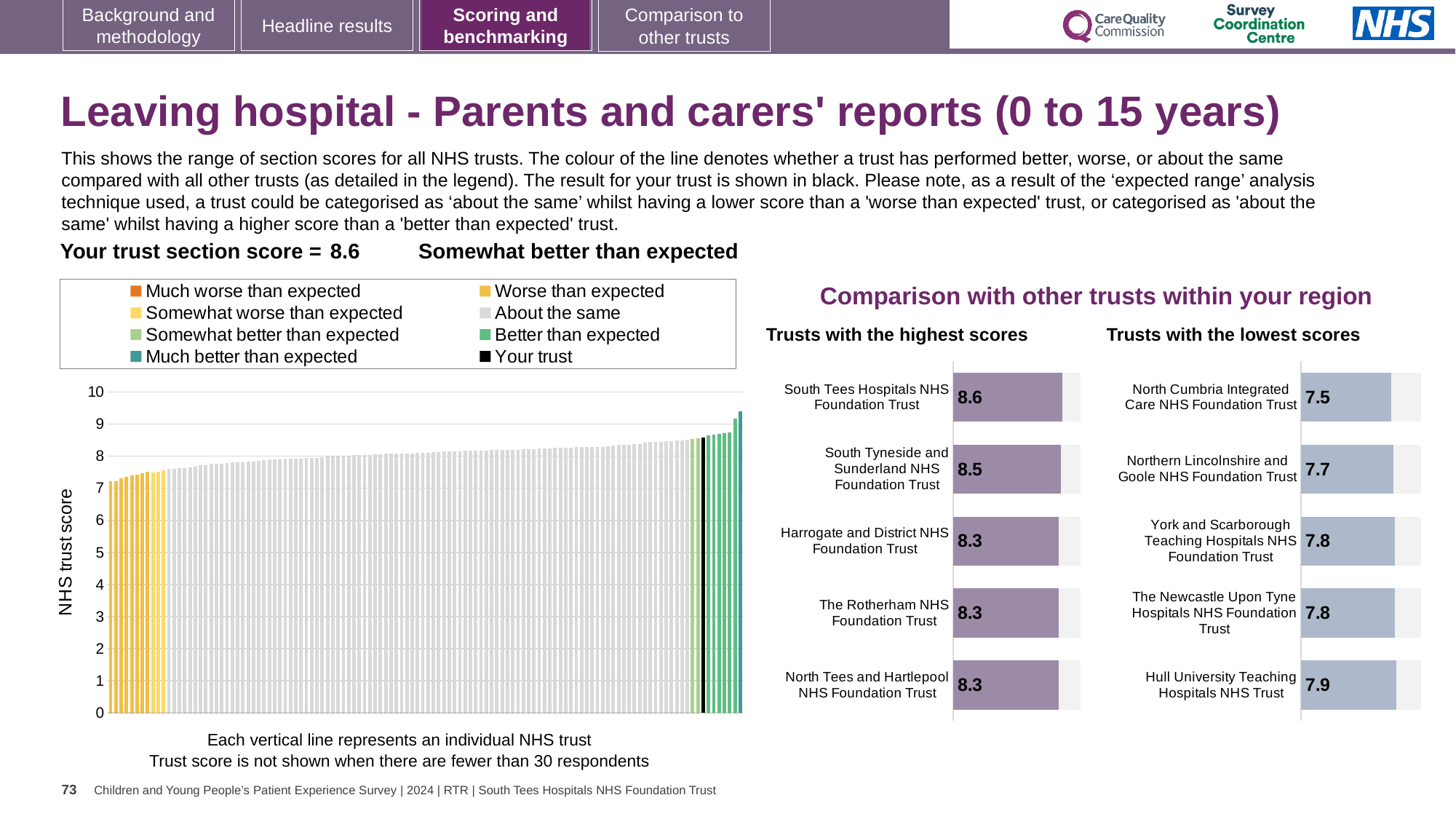
In the 'NHS trust score' chart, is the value of the tallest bar greater or less than 9? greater How many trusts are listed in the 'Trusts with the highest scores' chart? 5 In the 'Trusts with the highest scores' chart, what is the score for South Tees Hospitals NHS Foundation Trust? 8.6 How many entries does the legend of the 'NHS trust score' chart list? 8 In the 'Trusts with the lowest scores' chart, what is the score for North Cumbria Integrated Care NHS Foundation Trust? 7.5 In the 'Trusts with the lowest scores' chart, which has the larger score: Northern Lincolnshire and Goole NHS Foundation Trust or Hull University Teaching Hospitals NHS Trust? Hull University Teaching Hospitals NHS Trust What is the difference between the score for South Tees Hospitals NHS Foundation Trust in the highest scores chart and the score for North Cumbria Integrated Care NHS Foundation Trust in the lowest scores chart? 1.1 In the 'Trusts with the lowest scores' chart, which trust has the lowest score? North Cumbria Integrated Care NHS Foundation Trust What kind of chart is the 'NHS trust score' chart on the left of the slide? Bar chart In the 'Trusts with the highest scores' chart, what is the score for South Tyneside and Sunderland NHS Foundation Trust? 8.5 In the 'Trusts with the highest scores' chart, which trust has the highest score? South Tees Hospitals NHS Foundation Trust In the 'Trusts with the lowest scores' chart, what is the score for Hull University Teaching Hospitals NHS Trust? 7.9